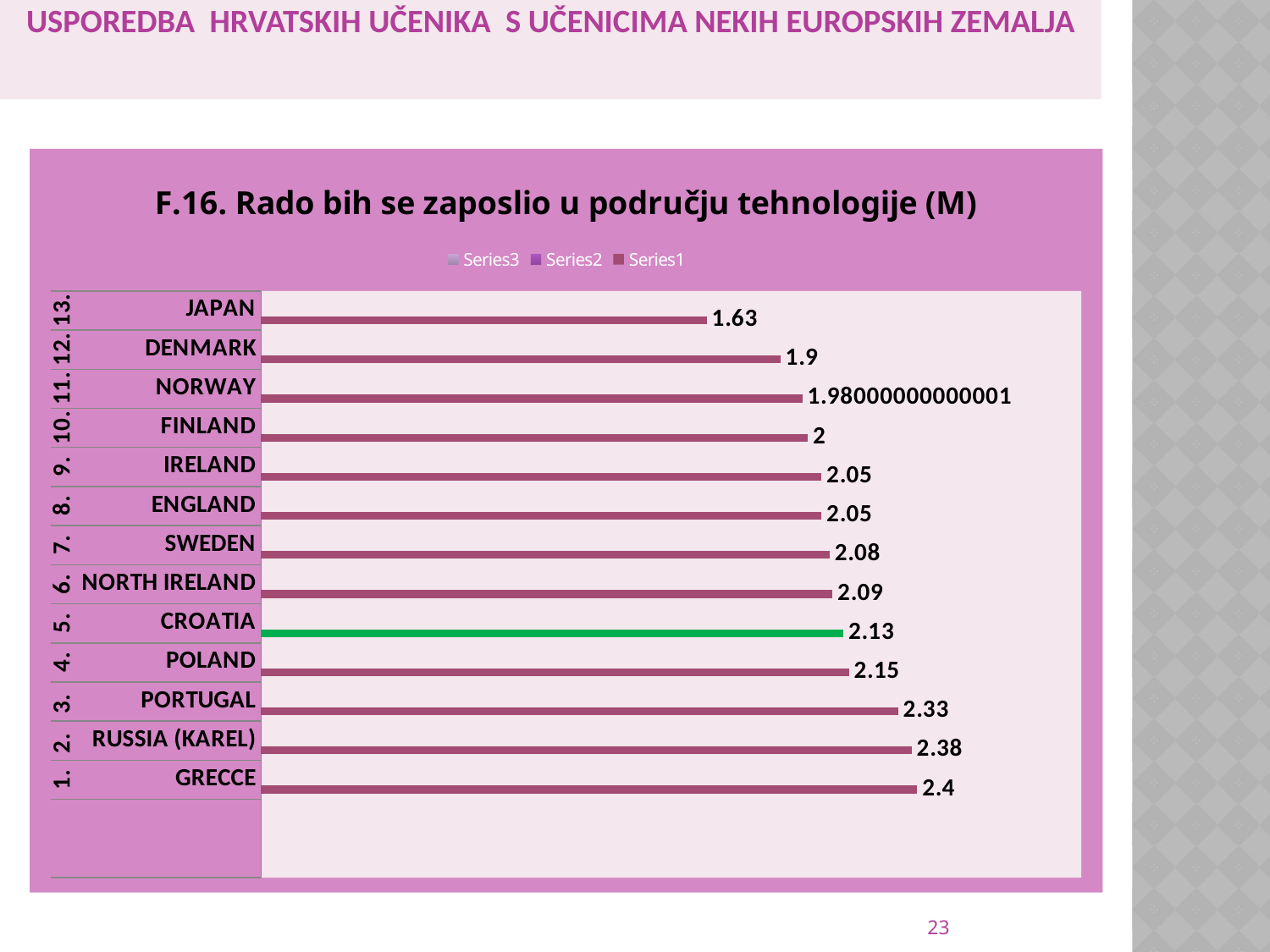
What is the title of the chart? F.16. Rado bih se zaposlio u području tehnologije (M) How many countries are shown in the chart? 13 Which country has the lowest value? JAPAN What is the value for JAPAN? 1.63 What is the value for CROATIA? 2.13 How many series does the legend list? 3 What is the value for PORTUGAL? 2.33 Which has a larger value, RUSSIA (KAREL) or DENMARK? RUSSIA (KAREL) Which country has the highest value? GRECCE What is the difference between the values for GRECCE and JAPAN? 0.77 What is the difference between the values for POLAND and CROATIA? 0.02 What kind of chart is shown on the slide? Bar chart